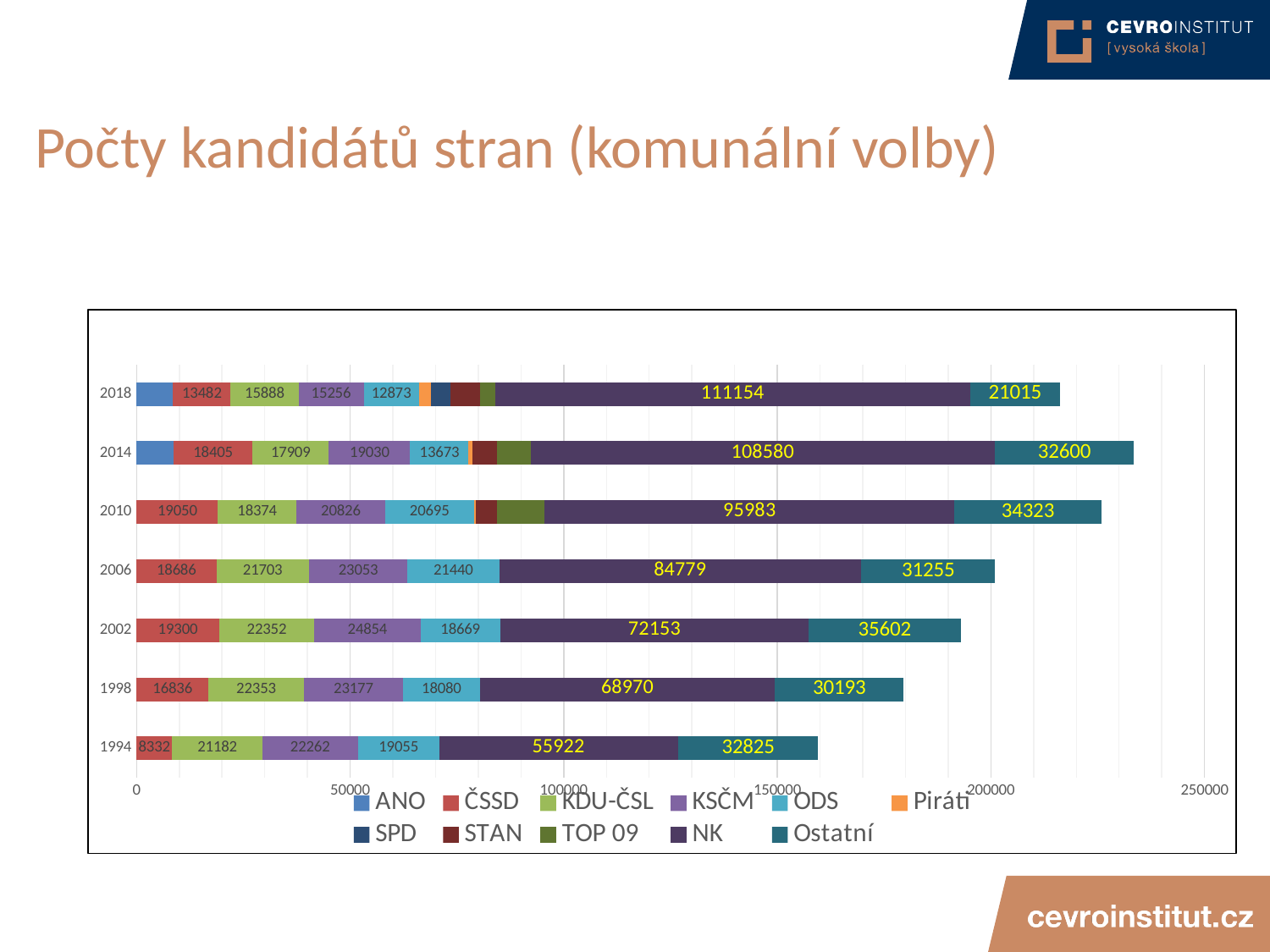
In which year is the NK value lowest? 1994 What is the value for Ostatní in 2002? 35602 In which year is the NK value highest? 2018 Which is larger, the Ostatní value for 2010 or for 2014? 2010 Is the total length of the 2018 bar greater or less than 200000? greater What is the value for ČSSD in 1994? 8332 What is the value for NK in 2018? 111154 How many years are shown on the chart? 7 What is the title of the slide? Počty kandidátů stran (komunální volby) What kind of chart is shown on the slide? Stacked bar chart How many series does the legend list? 11 What is the difference between the NK values for 2018 and 2014? 2574